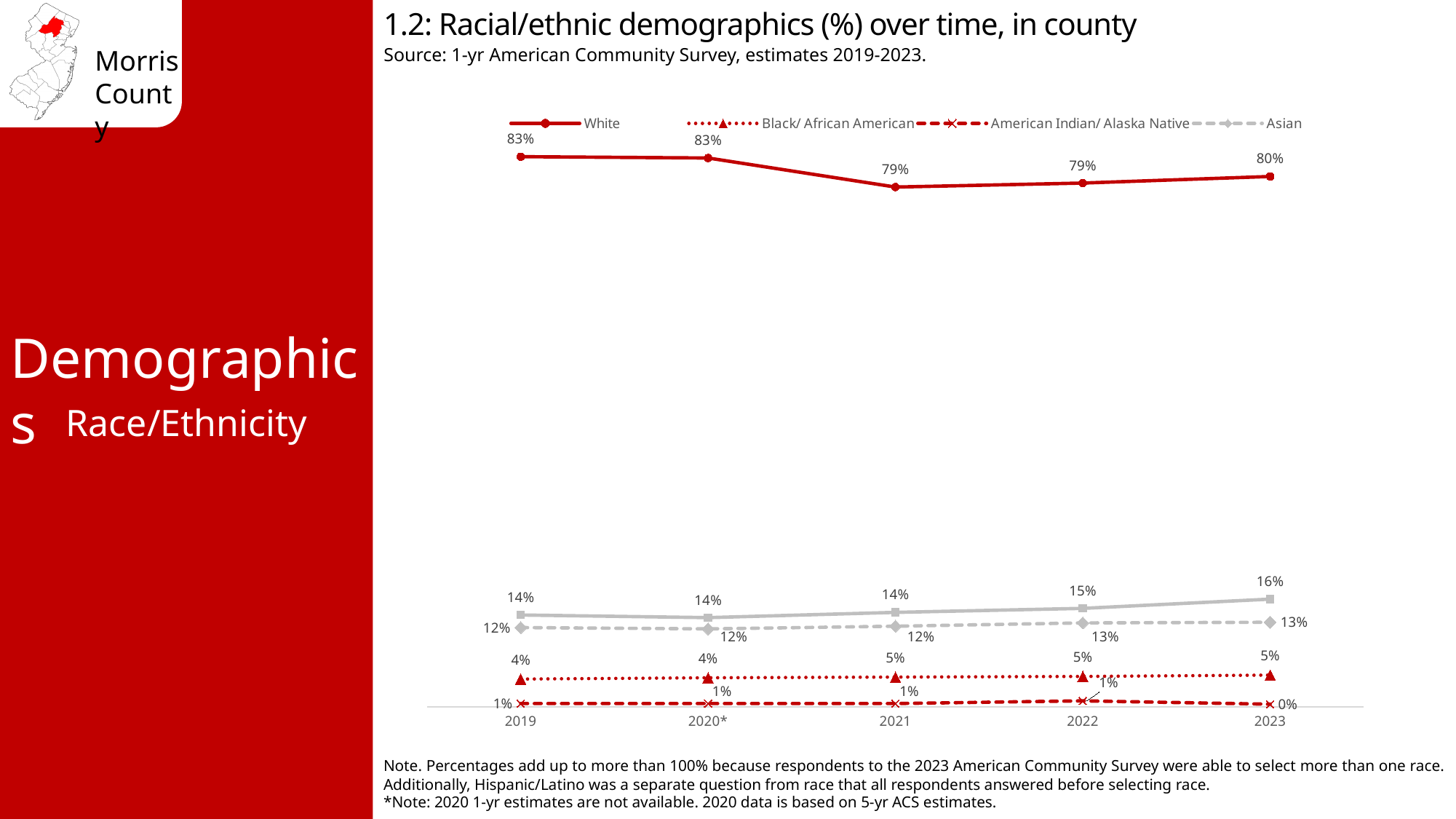
What was the Black/ African American percentage in 2021? 5% What was the American Indian/ Alaska Native percentage in 2023? 0% What data source is cited for the chart? 1-yr American Community Survey, estimates 2019-2023 In 2023, which was larger: the Asian share or the Black/ African American share? Asian What kind of chart is shown on the slide? line chart How many years are shown on the x axis? 5 Which racial/ethnic group had the highest percentage in 2023? White What was the Asian percentage in 2022? 13% What was the White percentage in 2019? 83% Did the White percentage rise or fall from 2019 to 2021? fall What was the White percentage in 2023? 80% By how many percentage points did the White share change from 2019 to 2023? 3 percentage points